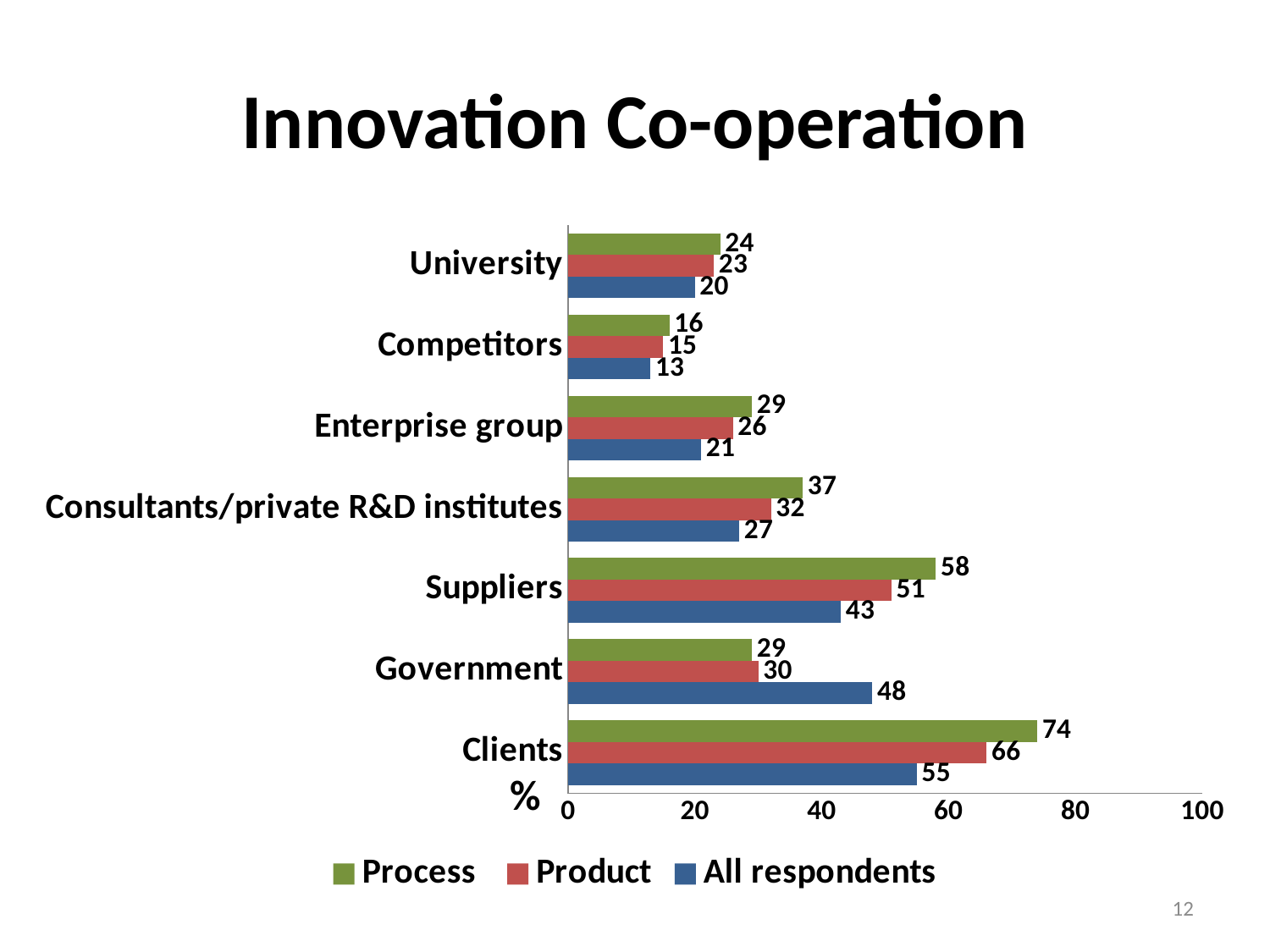
What is the Process value for Suppliers? 58 How many categories are shown on the chart? 7 Which colour represents the Product series in the legend? Red How many series does the legend list? 3 What is the difference between the Process and Product values for Clients? 8 Which category has the lowest All respondents value? Competitors What is the Product value for Consultants/private R&D institutes? 32 For Government, which is larger: the Product value or the All respondents value? All respondents What kind of chart is shown on the slide? Bar chart Which category has the highest Process value? Clients What is the title of the slide? Innovation Co-operation What is the All respondents value for Government? 48